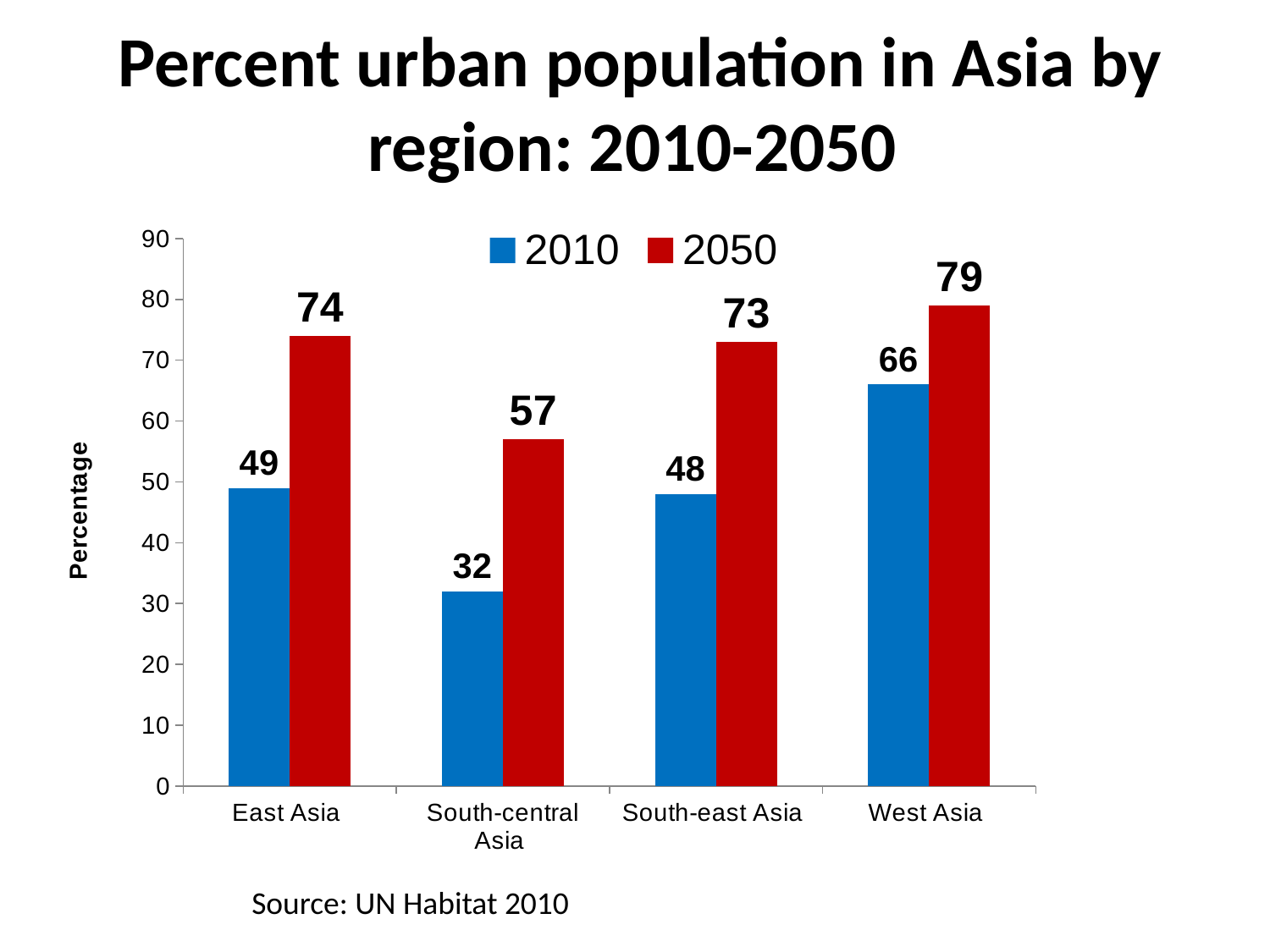
What is the 2050 value for South-central Asia? 57 What is the difference between the 2050 and 2010 values for South-east Asia? 25 What is the title of the chart? Percent urban population in Asia by region: 2010-2050 Which is larger: the 2050 value for East Asia or the 2050 value for South-east Asia? East Asia Is the 2010 value for South-central Asia greater or less than 40? less What is the 2010 value for West Asia? 66 How many regions are shown on the x axis? 4 What is the 2010 value for East Asia? 49 How many series does the legend list? 2 Which region has the highest 2050 value? West Asia What kind of chart is shown on the slide? bar chart Which region has the lowest 2010 value? South-central Asia